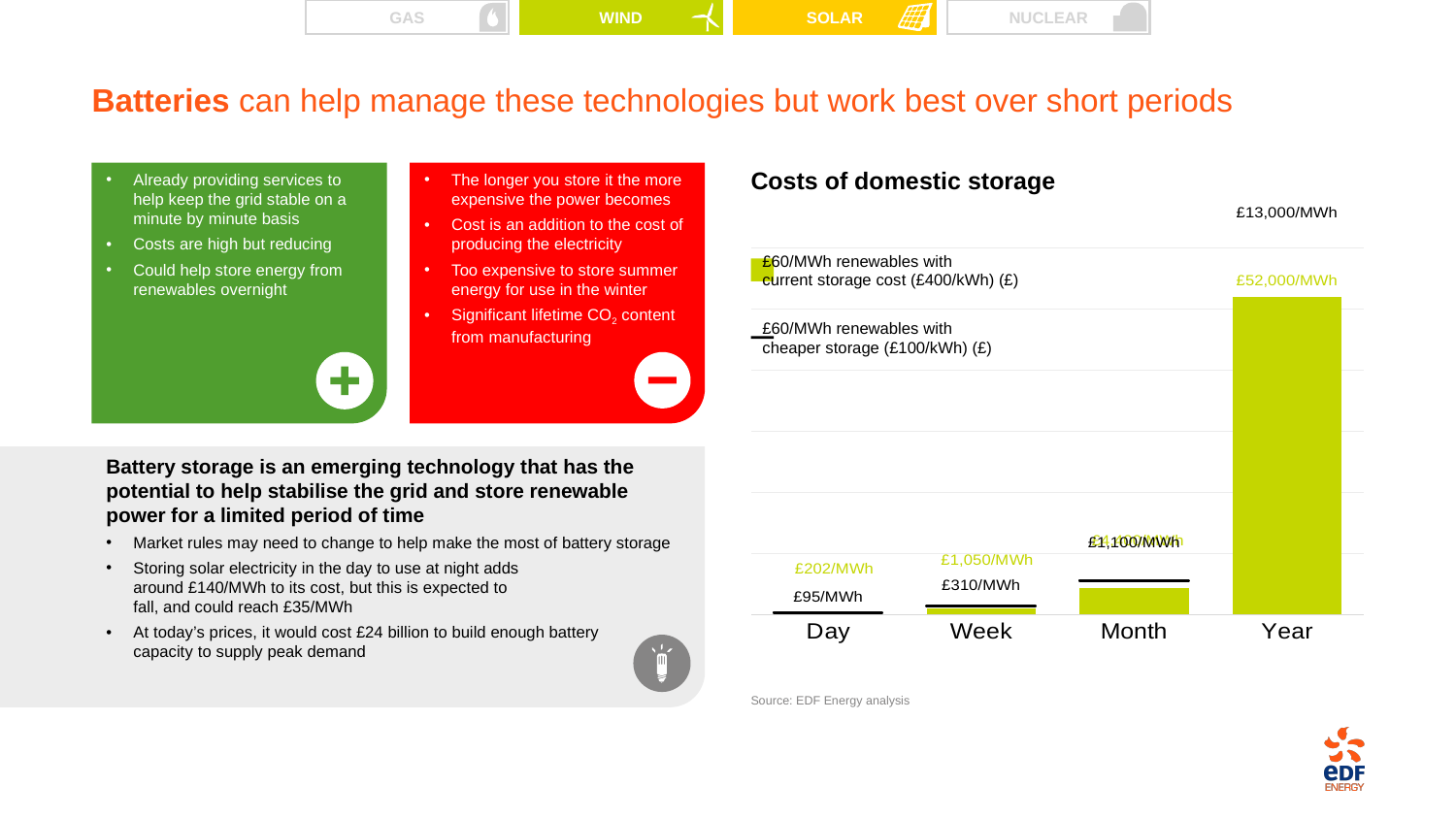
In the 'Costs of domestic storage' chart, what is the value for Year with cheaper storage (£100/kWh)? £13,000/MWh What kind of chart is shown under the title 'Costs of domestic storage'? bar chart In the 'Costs of domestic storage' chart, what is the value for Day with current storage cost (£400/kWh)? £202/MWh In the 'Costs of domestic storage' chart, which category has the highest cost with current storage cost (£400/kWh)? Year In the 'Costs of domestic storage' chart, do the costs rise or fall from Day to Year? rise In the 'Costs of domestic storage' chart, what is the difference between the current storage cost and the cheaper storage cost for Year? £39,000/MWh How many categories are shown on the x axis of the 'Costs of domestic storage' chart? 4 In the 'Costs of domestic storage' chart, what is the value for Week with current storage cost (£400/kWh)? £1,050/MWh How many series does the legend of the 'Costs of domestic storage' chart list? 2 In the 'Costs of domestic storage' chart, what is the value for Day with cheaper storage (£100/kWh)? £95/MWh In the 'Costs of domestic storage' chart, what is the value for Year with current storage cost (£400/kWh)? £52,000/MWh In the 'Costs of domestic storage' chart, what is the value for Week with cheaper storage (£100/kWh)? £310/MWh